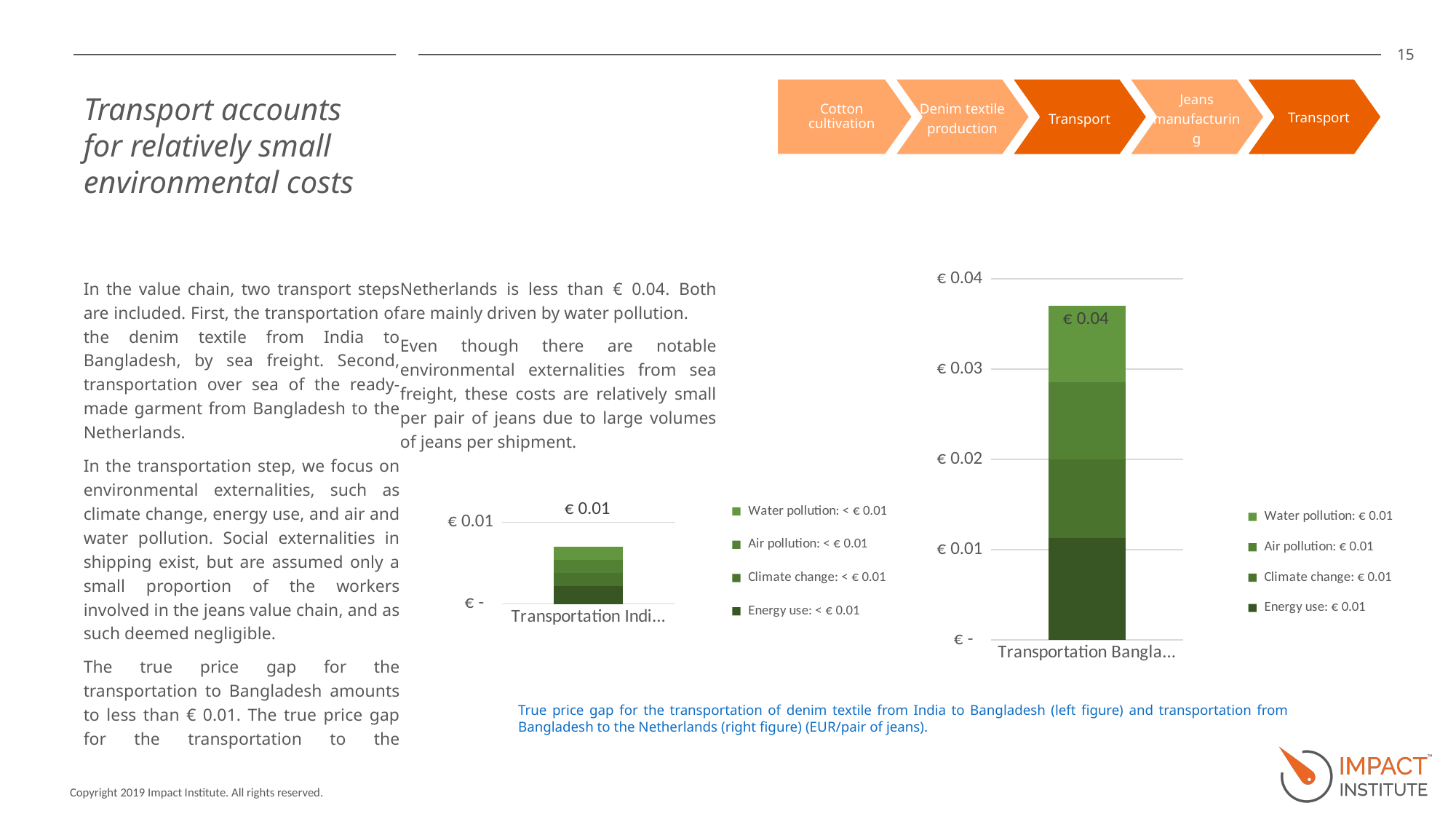
What kind of chart is the right-hand chart (Transportation Bangladesh to the Netherlands)? Stacked bar chart How many bars are plotted in the right-hand chart? 1 What is the difference between the total of the right-hand chart bar and the total of the left-hand chart bar? € 0.03 How many series does the legend of the right-hand chart list? 4 In the right-hand chart, what is the total true price gap shown on the bar? € 0.04 In the left-hand chart, what is the total true price gap shown on the bar? € 0.01 In the right-hand chart, what value does the legend give for Energy use? € 0.01 How many series does the legend of the left-hand chart list? 4 In the left-hand chart, what value does the legend give for Climate change? < € 0.01 Which chart shows the larger total true price gap, the left-hand chart or the right-hand chart? The right-hand chart Is the total of the bar in the right-hand chart greater or less than € 0.03? greater In the right-hand chart, what value does the legend give for Water pollution? € 0.01